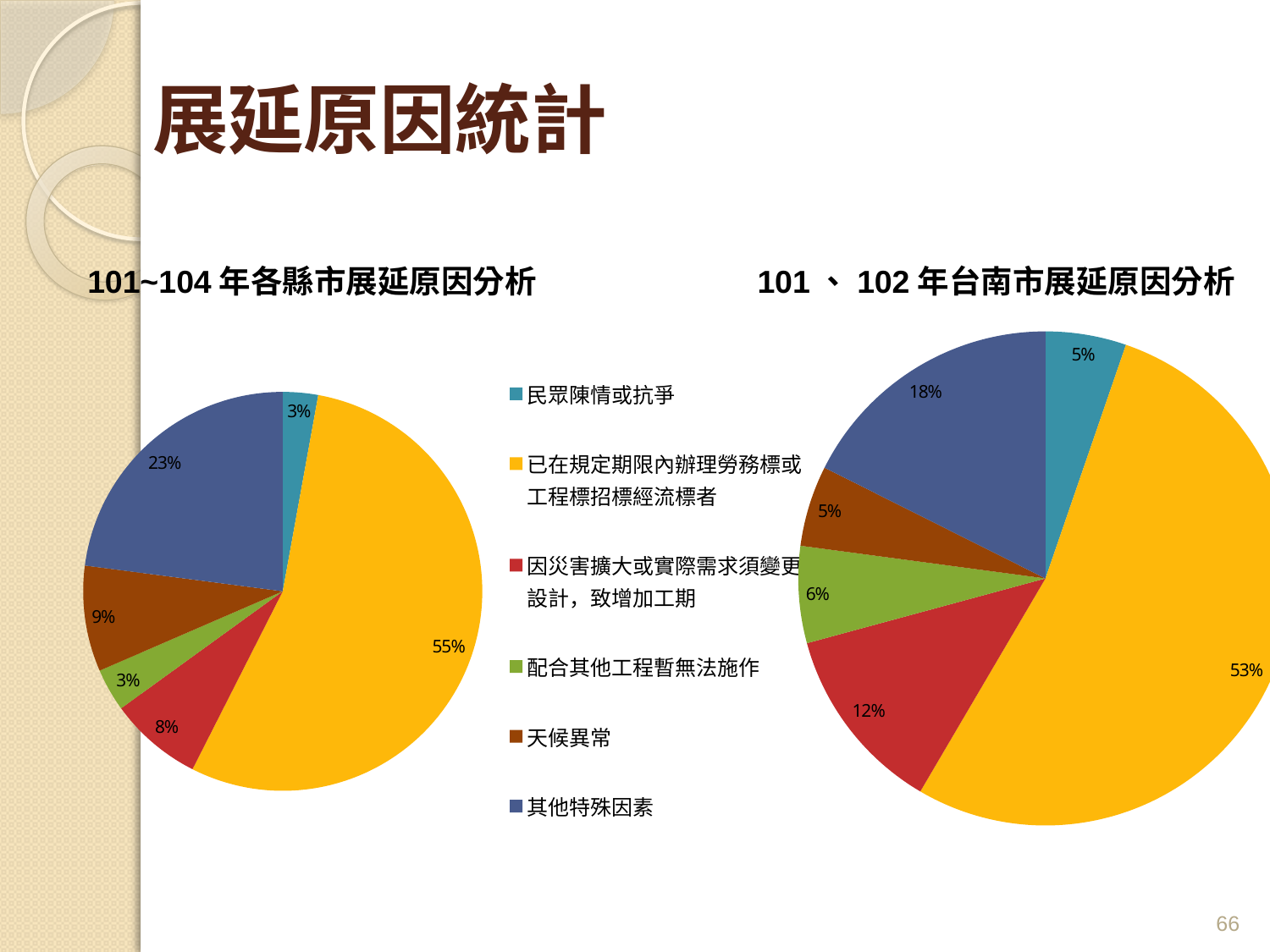
In the left chart (101~104 年各縣市展延原因分析), what share does 天候異常 have? 9% Which chart shows a larger share for 其他特殊因素, the left chart (101~104 年各縣市) or the right chart (101、102 年台南市)? the left chart What kind of chart is the left chart titled 101~104 年各縣市展延原因分析? pie chart What colour represents 天候異常 in the pie charts? brown In the right chart (101、102 年台南市展延原因分析), what share does 因災害擴大或實際需求須變更設計，致增加工期 have? 12% How many categories does the legend list for the pie charts? 6 In the left chart (101~104 年各縣市展延原因分析), which category has the largest share? 已在規定期限內辦理勞務標或工程標招標經流標者 In the right chart (101、102 年台南市展延原因分析), what share does 其他特殊因素 have? 18% In the left chart (101~104 年各縣市展延原因分析), what is the difference between the shares of 其他特殊因素 and 因災害擴大或實際需求須變更設計，致增加工期? 15% In the right chart (101、102 年台南市展延原因分析), what share does 已在規定期限內辦理勞務標或工程標招標經流標者 have? 53% In the right chart (101、102 年台南市展延原因分析), which is larger: the share of 配合其他工程暫無法施作 or the share of 天候異常? 配合其他工程暫無法施作 In the left chart (101~104 年各縣市展延原因分析), what share does 其他特殊因素 have? 23%